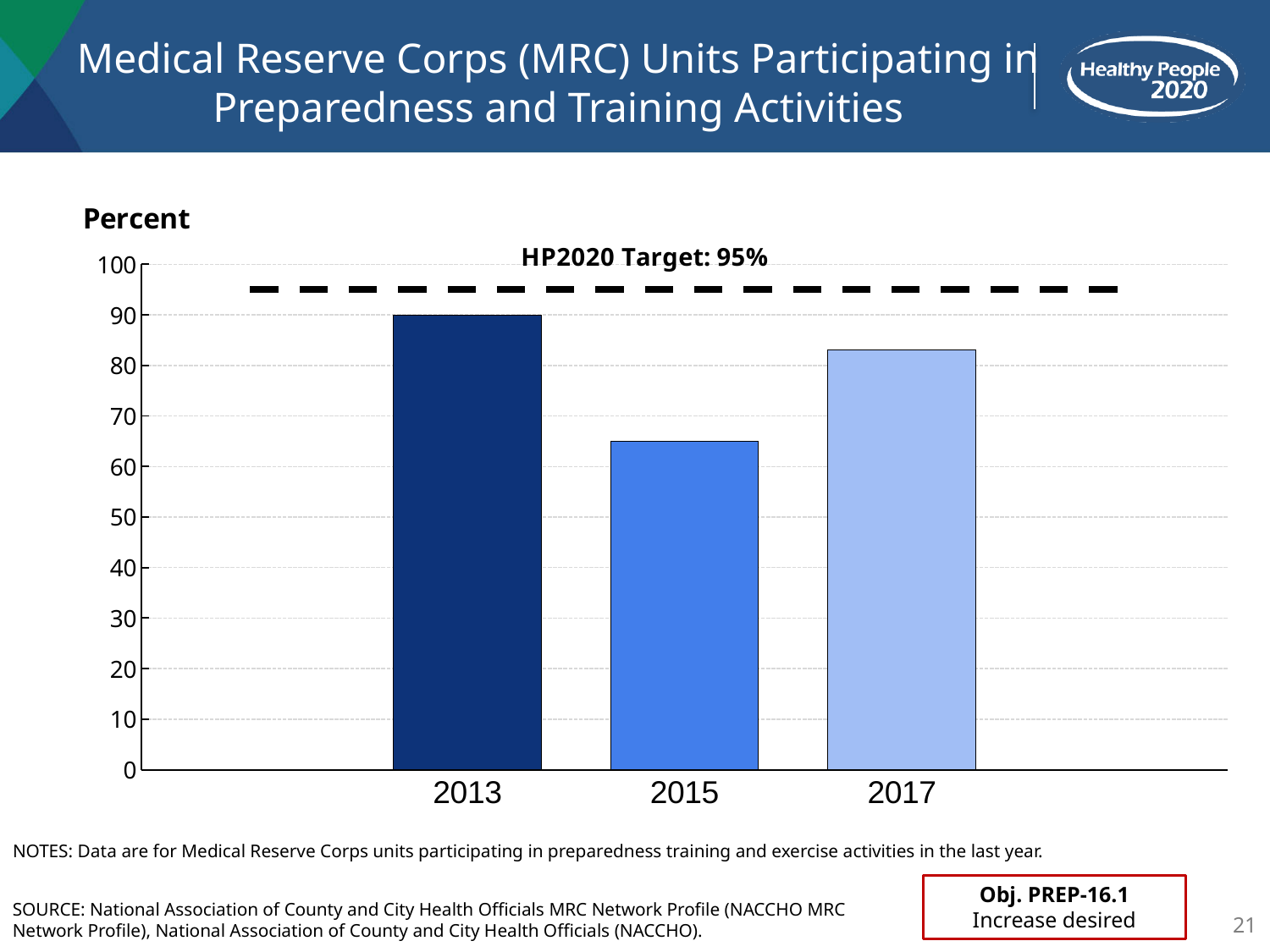
Do the values rise or fall from 2013 to 2015? fall Is the value for 2013 greater or less than 95? less What kind of chart is shown on the slide? bar chart Which year has the lowest percentage of MRC units participating in preparedness and training activities? 2015 Is the value for 2017 greater or less than 80? greater Which year has the highest percentage of MRC units participating in preparedness and training activities? 2013 What is the HP2020 target shown on the chart? 95% What is the label on the vertical axis of the chart? Percent Which year has the larger value, 2013 or 2017? 2013 Is the value for 2015 greater or less than 70? less Which year has the larger value, 2015 or 2017? 2017 How many years are plotted on the chart? 3